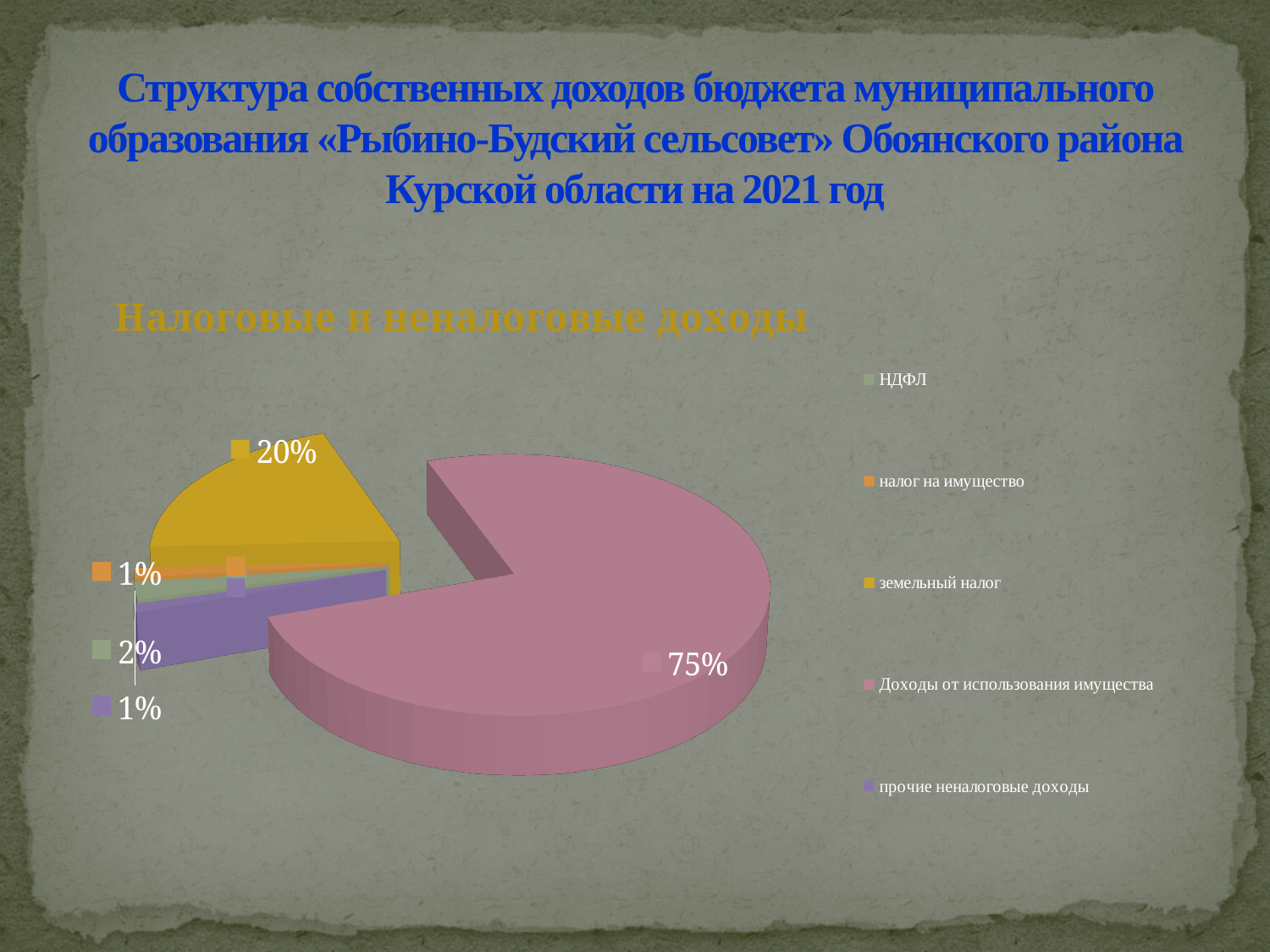
What share of the pie is НДФЛ? 2% What share of the pie is Доходы от использования имущества? 75% What share of the pie is земельный налог? 20% What kind of chart is shown on the slide? pie chart Which colour represents земельный налог in the chart? yellow How many categories does the legend list? 5 What is the chart's title? Налоговые и неналоговые доходы Which is larger, the share of земельный налог or the share of НДФЛ? земельный налог What is the difference between the shares of Доходы от использования имущества and земельный налог? 55% Which category has the largest share of the pie? Доходы от использования имущества